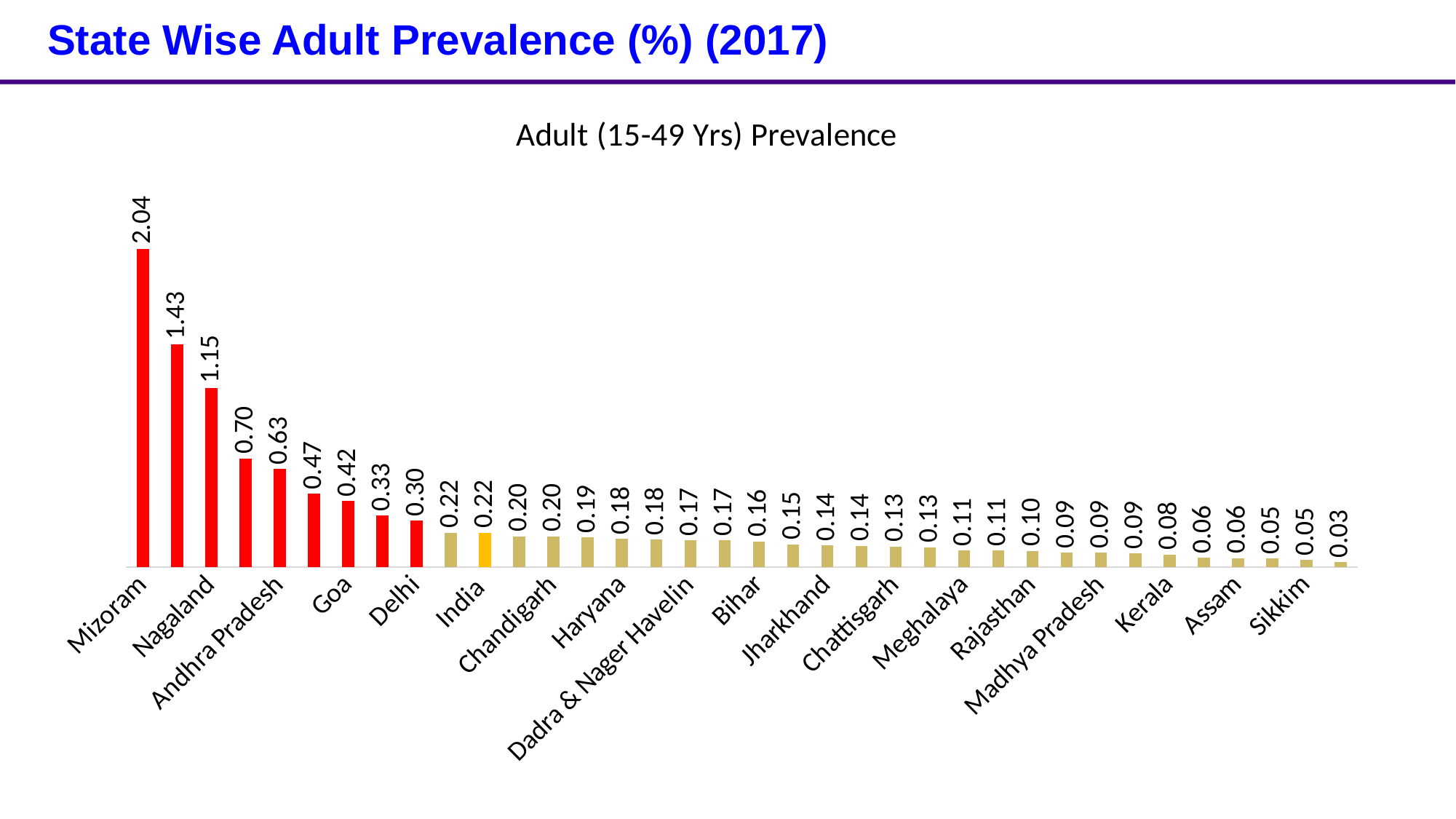
Which state has the highest adult prevalence in the chart? Mizoram What is the adult prevalence value for Delhi? 0.30 What is the adult prevalence value for Mizoram? 2.04 Which has a higher adult prevalence, Goa or Delhi? Goa What colour is the bar for India? Yellow What type of chart is shown on the slide? Bar chart What is the adult prevalence value for Nagaland? 1.15 What is the adult prevalence value for Kerala? 0.08 What is the adult prevalence value for Goa? 0.42 What is the title shown above the chart? Adult (15-49 Yrs) Prevalence What is the difference between the adult prevalence values for Mizoram and Nagaland? 0.89 What is the adult prevalence value for India? 0.22